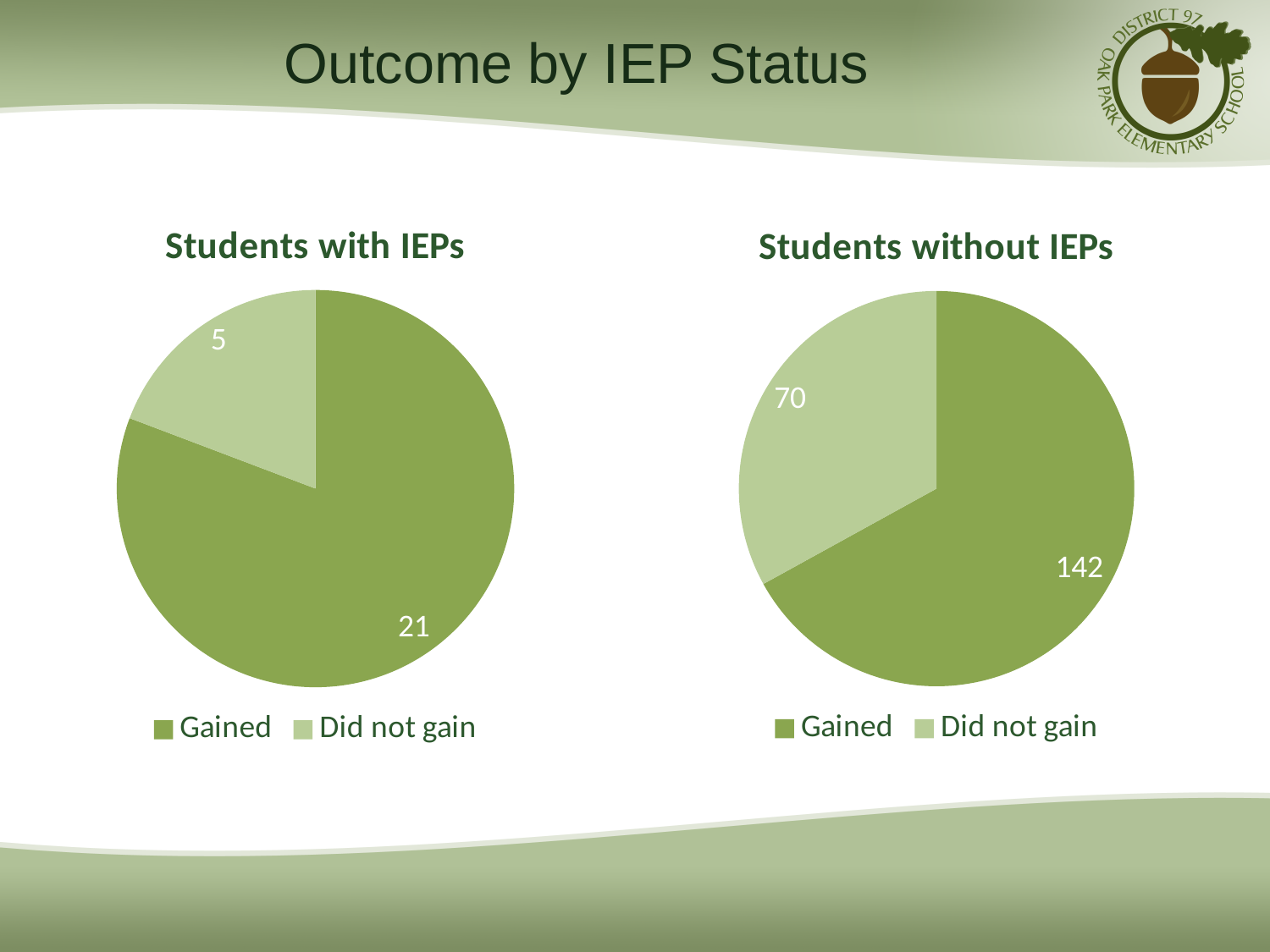
How many series does the legend of the 'Students without IEPs' chart list? 2 What type of chart is used for 'Students with IEPs'? Pie chart In the 'Students without IEPs' chart, what is the value for Did not gain? 70 In the 'Students without IEPs' chart, which category has the largest slice? Gained In the 'Students with IEPs' chart, what is the value for Gained? 21 In the 'Students with IEPs' chart, what is the value for Did not gain? 5 In the 'Students with IEPs' chart, what is the difference between Gained and Did not gain? 16 In the 'Students without IEPs' chart, what is the difference between Gained and Did not gain? 72 In the 'Students with IEPs' chart, which category has the smallest slice? Did not gain Which is larger: Did not gain in the 'Students with IEPs' chart or Did not gain in the 'Students without IEPs' chart? Students without IEPs In the 'Students without IEPs' chart, what is the value for Gained? 142 In the 'Students without IEPs' chart, what share of the pie does Did not gain represent? 33%